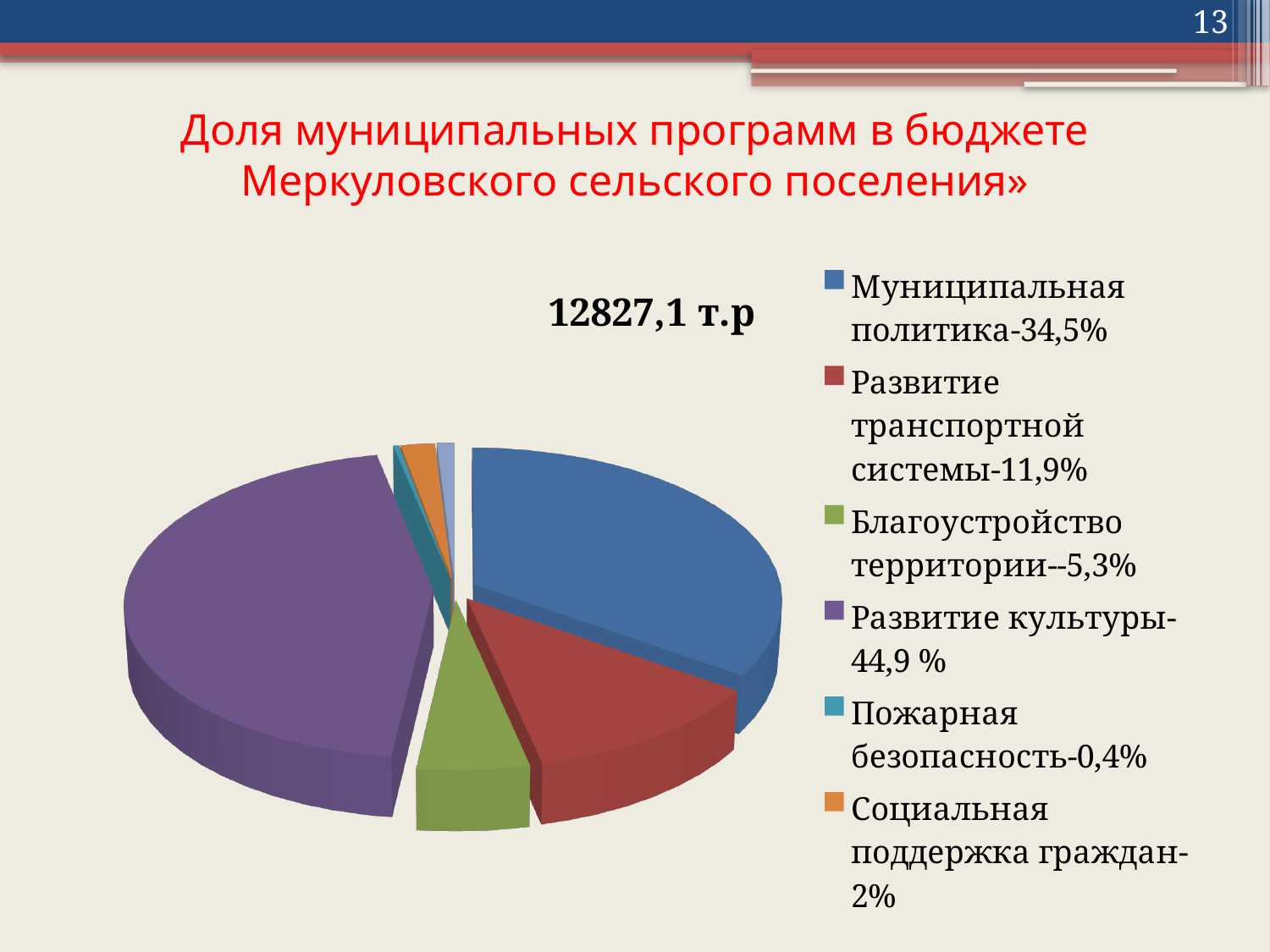
What kind of chart is shown on the slide? pie chart What share of the budget does "Развитие транспортной системы" have? 11,9% What share of the budget does "Развитие культуры" have? 44,9 % What share of the budget does "Муниципальная политика" have? 34,5% Which has a larger share: "Муниципальная политика" or "Развитие транспортной системы"? Муниципальная политика How many entries does the legend list? 6 What total amount is printed above the pie chart? 12827,1 т.р Which program has the largest share of the budget? Развитие культуры Which program listed in the legend has the smallest share of the budget? Пожарная безопасность